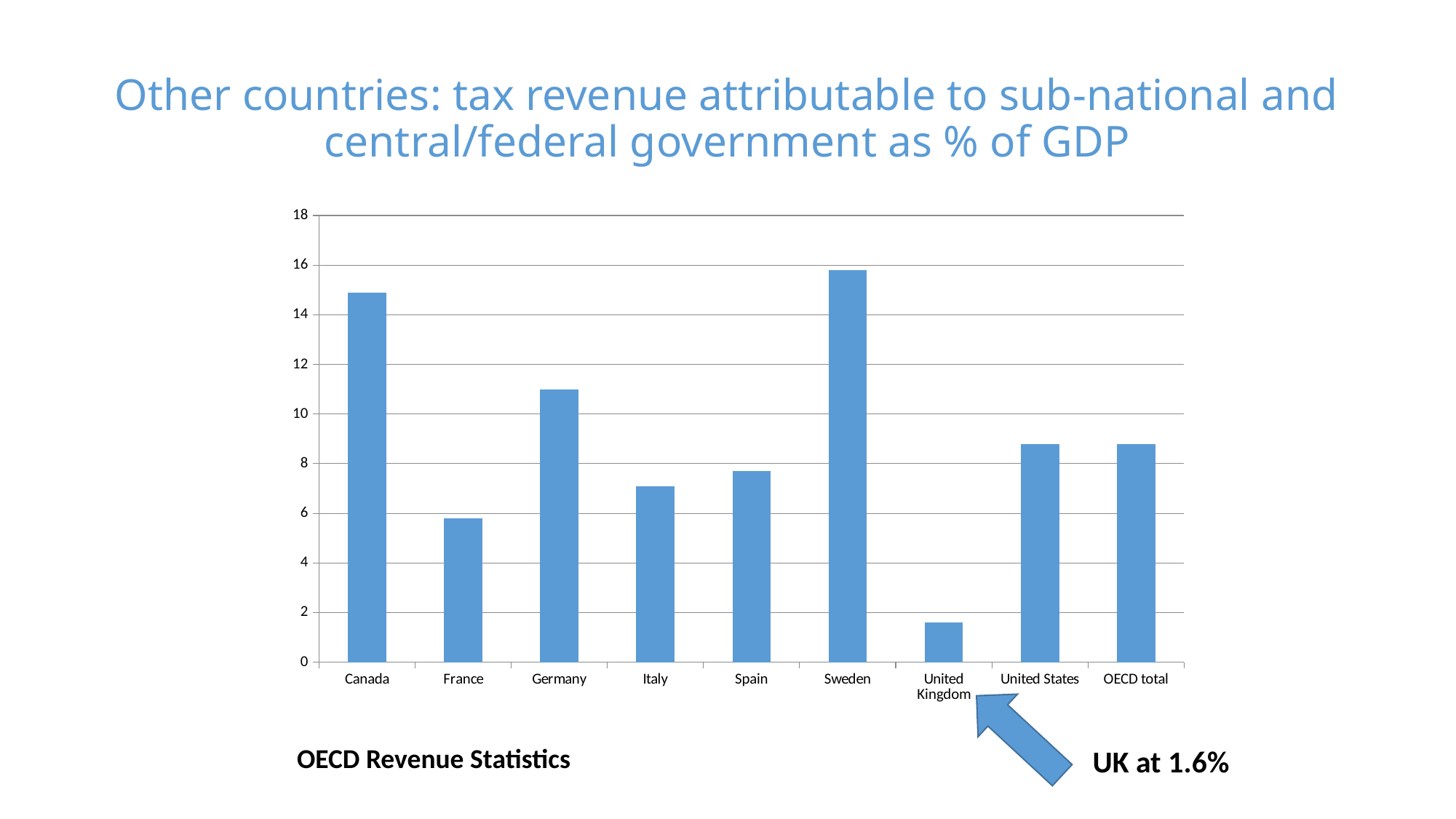
What type of chart is shown on the slide? bar chart Which category has the lowest value in the chart? United Kingdom Is the value for Spain greater or less than 8? less Is the value for France greater or less than 6? less What is the value for the United Kingdom, as annotated on the slide? 1.6% Which has a larger value, France or Italy? Italy Which has a larger value, Canada or Germany? Canada Is the value for Germany greater or less than 10? greater Which category has the highest value in the chart? Sweden How many categories (bars) are shown in the chart? 9 What source is cited below the chart? OECD Revenue Statistics